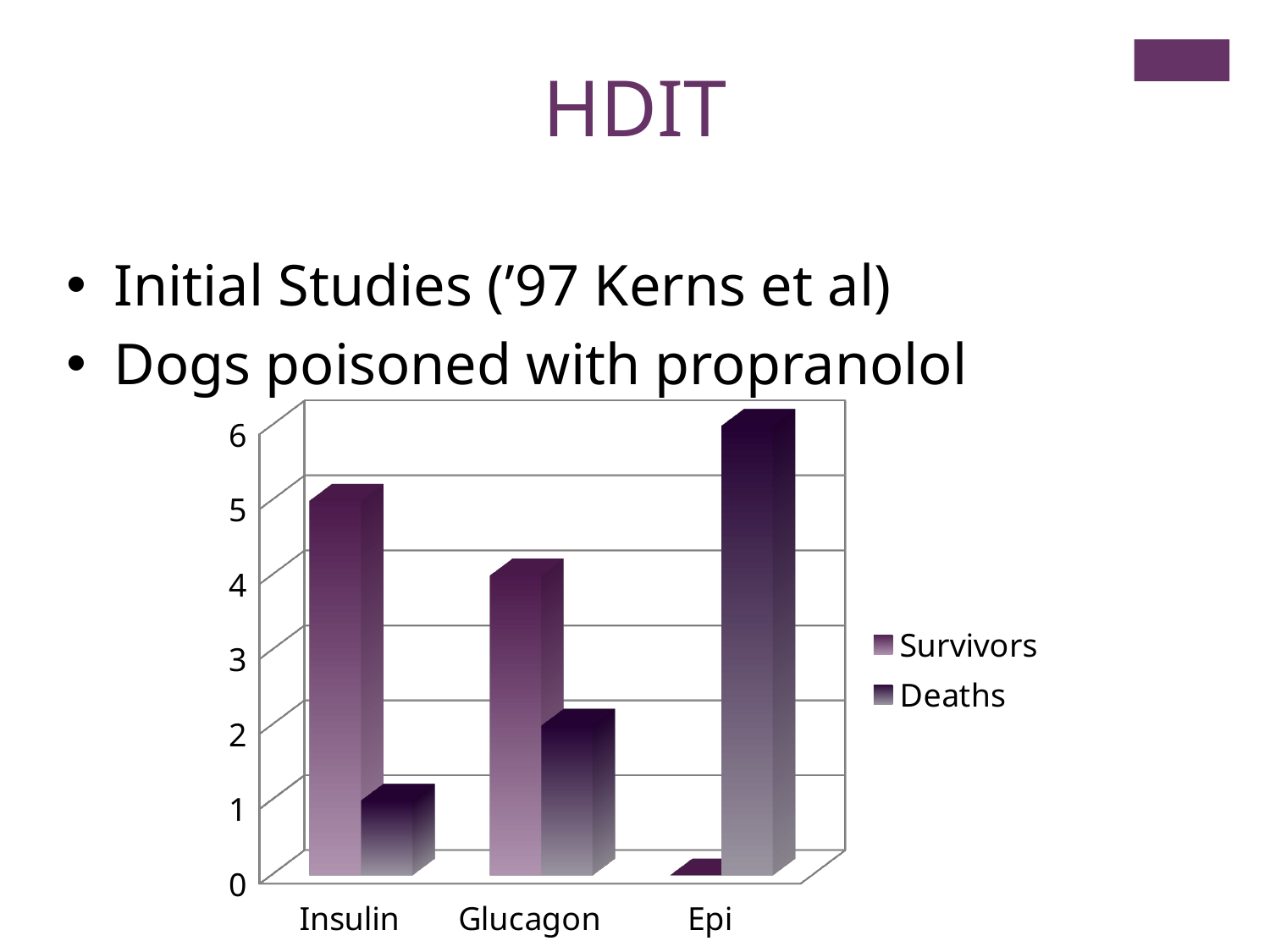
What kind of chart is shown on the slide? bar chart Which category has the highest number of Deaths? Epi What are the two series named in the chart legend? Survivors and Deaths Which category has the highest number of Survivors? Insulin Which category has the lowest number of Deaths? Insulin How many categories are shown on the x axis of the chart? 3 For Glucagon, which is larger: Survivors or Deaths? Survivors For Epi, which is larger: Survivors or Deaths? Deaths Is the number of Survivors for Insulin greater or less than 3? greater Is the number of Deaths for Glucagon greater or less than 3? less How many series does the chart legend list? 2 Which category has the lowest number of Survivors? Epi